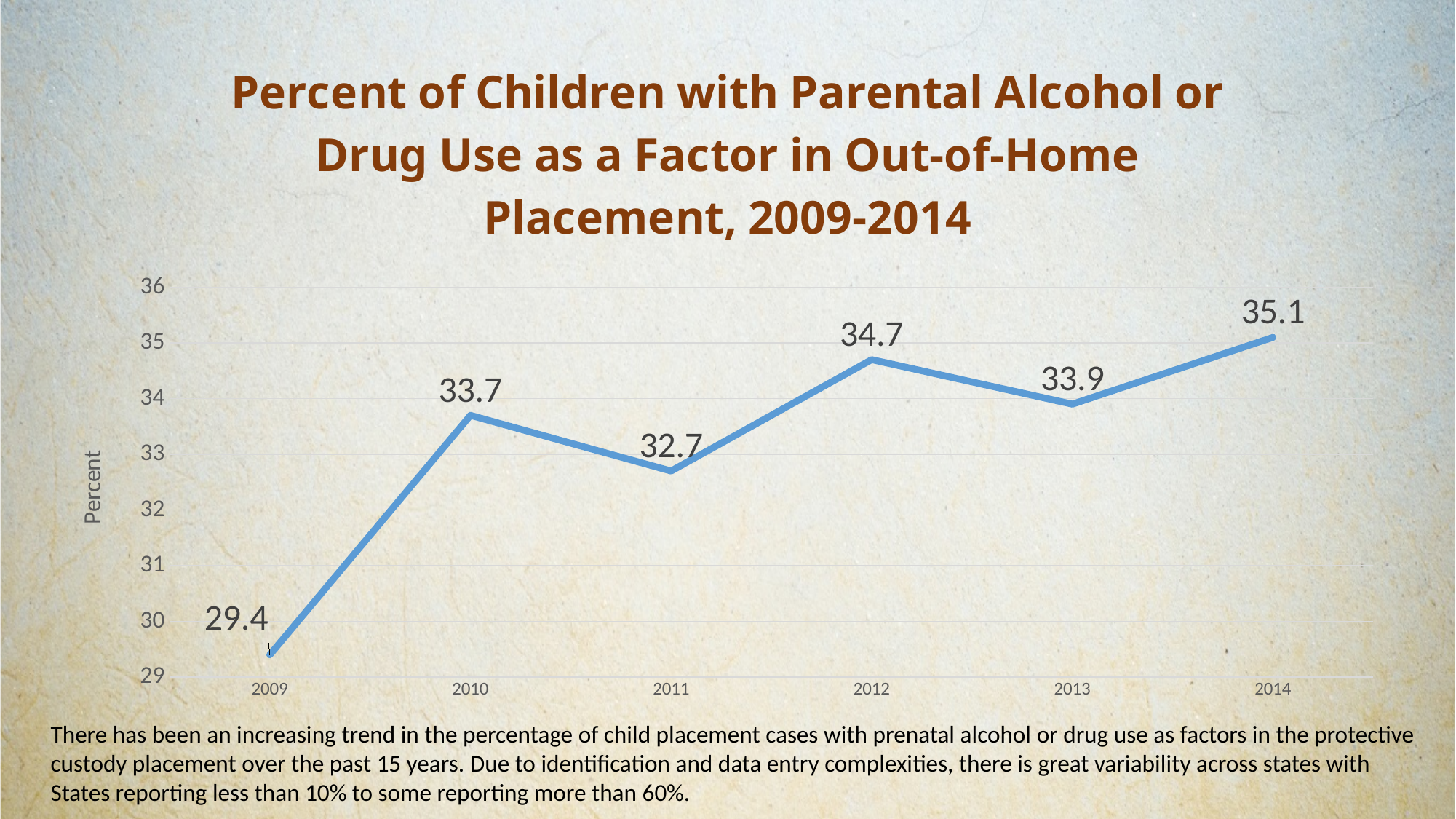
What kind of chart is shown on the slide? line chart What is the value for 2012? 34.7 Which year has the lowest value? 2009 What is the value for 2009? 29.4 Is the value for 2011 greater or less than 33? less What is the value for 2014? 35.1 How many years are plotted on the chart? 6 What is the label on the vertical axis? Percent What is the difference between the values for 2012 and 2011? 2 What is the difference between the values for 2014 and 2009? 5.7 Which is larger, the value for 2010 or the value for 2013? 2013 Which year has the highest value? 2014